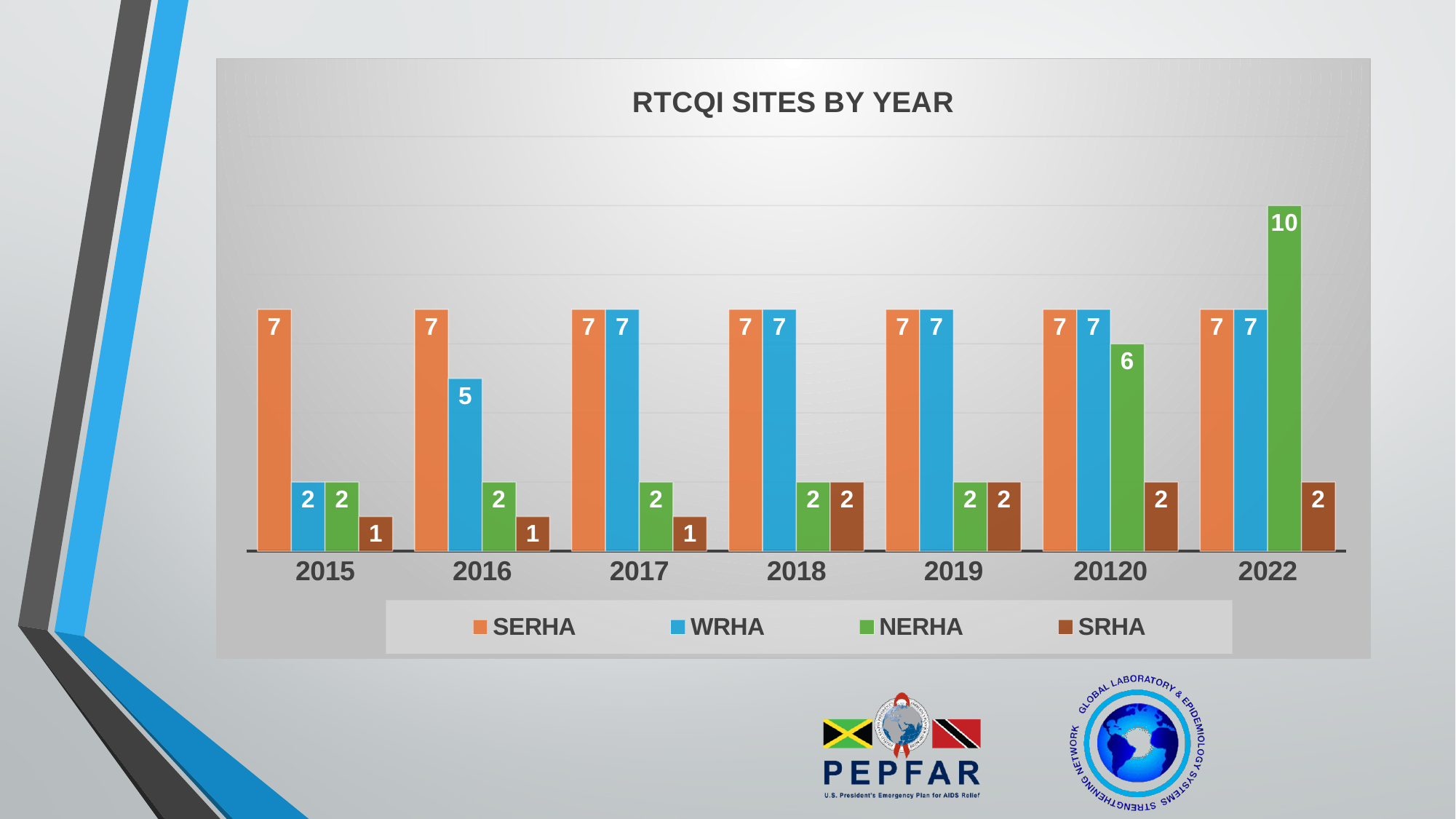
What type of chart is shown on the slide? bar chart What is the difference between the NERHA values in 2022 and 2019? 8 What is the value for SRHA in 2017? 1 What is the title of the chart? RTCQI SITES BY YEAR How many year categories are shown on the x axis? 7 What is the value for NERHA in 2022? 10 Which series has the lowest value in 2015? SRHA Which is larger, the WRHA value in 2015 or the WRHA value in 2016? 2016 Does the NERHA value rise or fall from 2019 to 2022? rise How many series does the legend list? 4 Which series has the highest value in 2022? NERHA What is the value for WRHA in 2016? 5